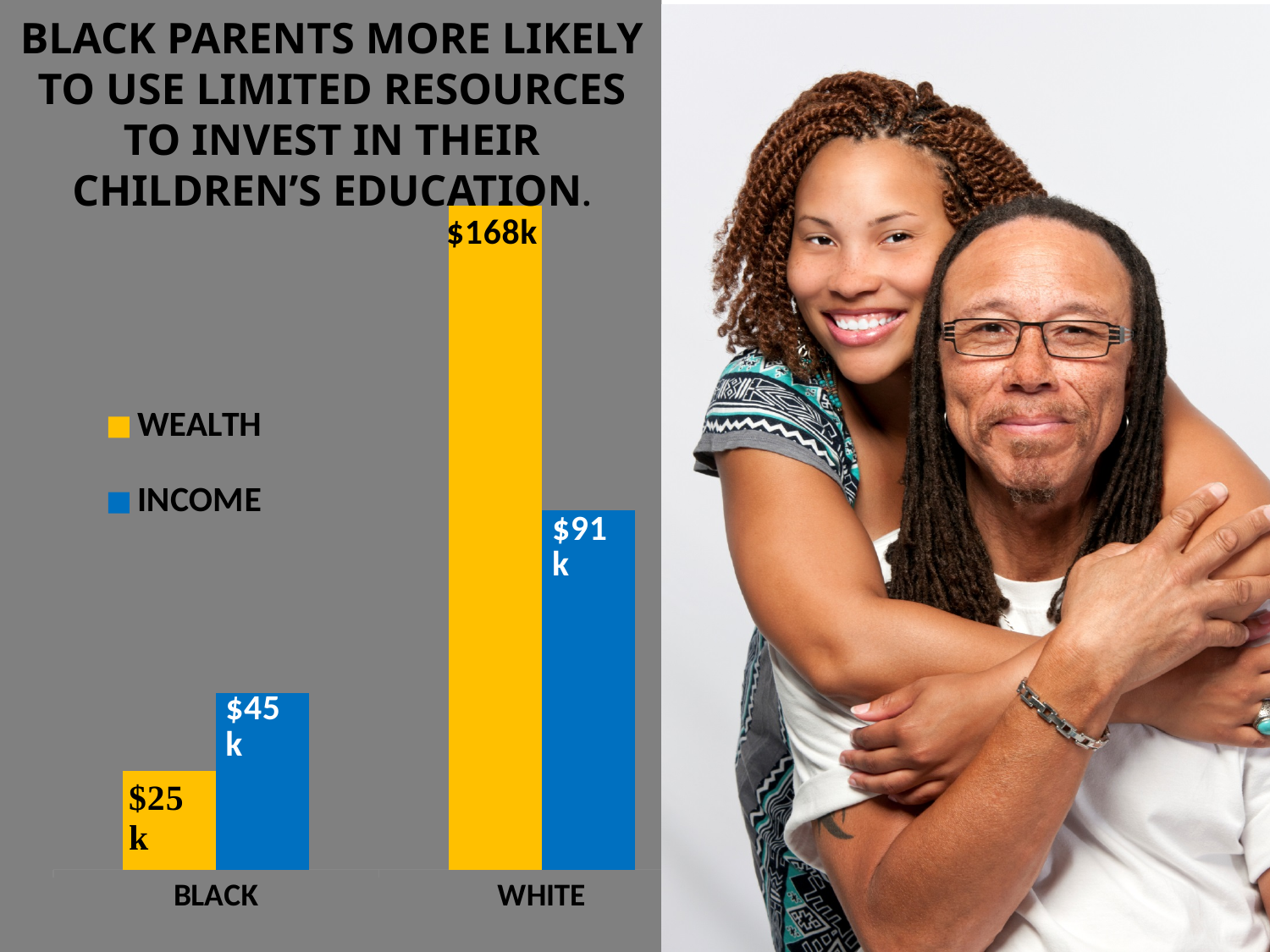
What kind of chart is shown on the slide? Bar chart Which bar in the chart has the lowest value? BLACK WEALTH For BLACK, which is larger, WEALTH or INCOME? INCOME What is the difference between the INCOME values for WHITE and BLACK? $46k Which bar in the chart has the highest value? WHITE WEALTH What is the INCOME value for WHITE? $91k What is the difference between the WEALTH values for WHITE and BLACK? $143k What is the WEALTH value for BLACK? $25k How many series does the chart's legend list? 2 What is the WEALTH value for WHITE? $168k What is the INCOME value for BLACK? $45k How many categories are shown on the x axis of the chart? 2